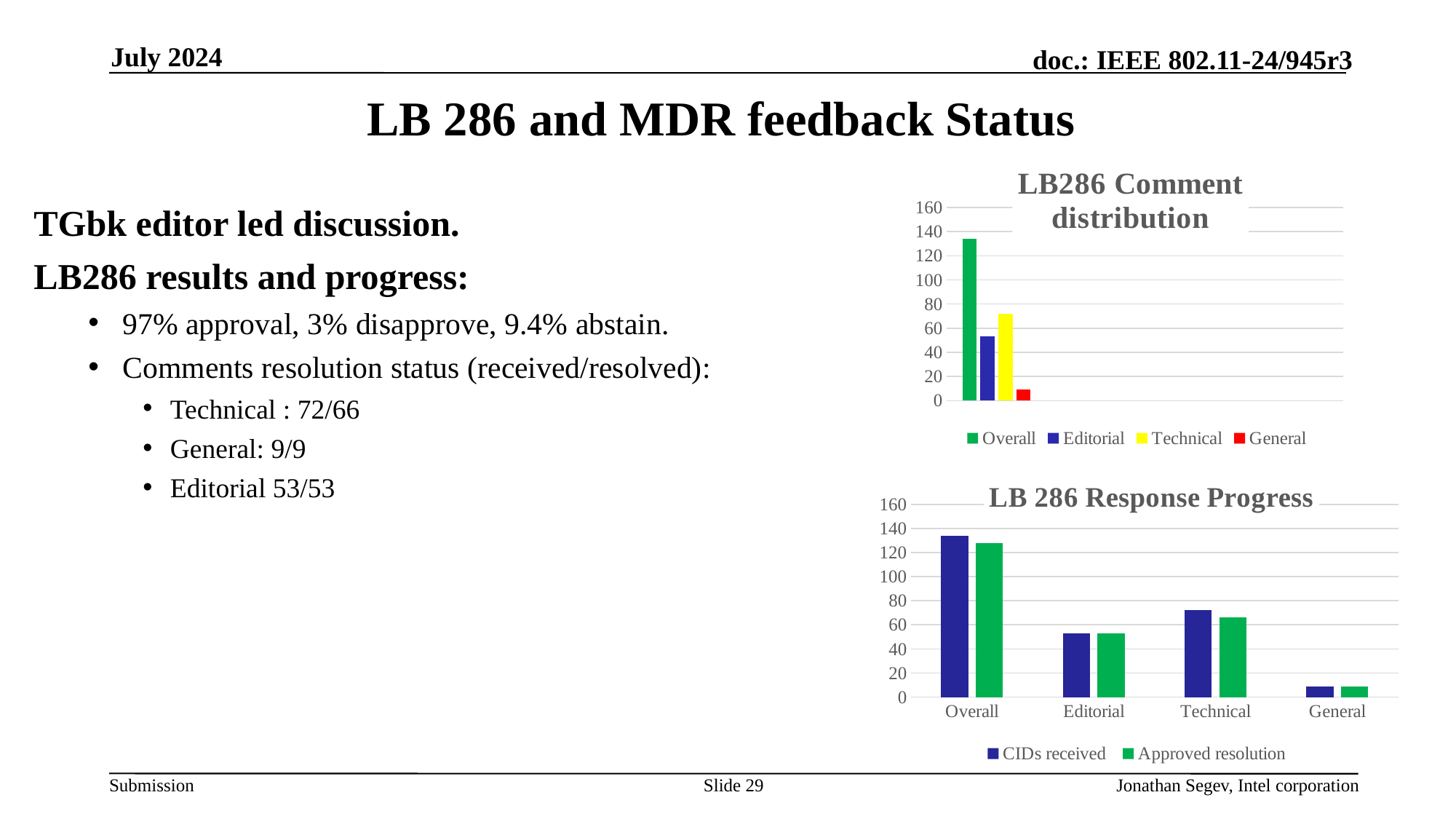
In the "LB286 Comment distribution" chart, is the value for Overall greater or less than 120? greater In the "LB 286 Response Progress" chart, which is larger for Technical: CIDs received or Approved resolution? CIDs received In the "LB 286 Response Progress" chart, how many categories are shown on the x axis? 4 In the "LB286 Comment distribution" chart, is the value for Technical greater or less than 60? greater In the "LB 286 Response Progress" chart, how many series does the legend list? 2 In the "LB 286 Response Progress" chart, is the CIDs received value for Editorial greater or less than 60? less In the "LB286 Comment distribution" chart, which series has the tallest bar? Overall In the "LB 286 Response Progress" chart, which category has the highest CIDs received value? Overall What kind of chart is the "LB286 Comment distribution" chart? bar chart In the "LB286 Comment distribution" chart, how many series does the legend list? 4 In the "LB286 Comment distribution" chart, which series has the shortest bar? General In the "LB286 Comment distribution" chart, which colour is used for the Technical series? yellow